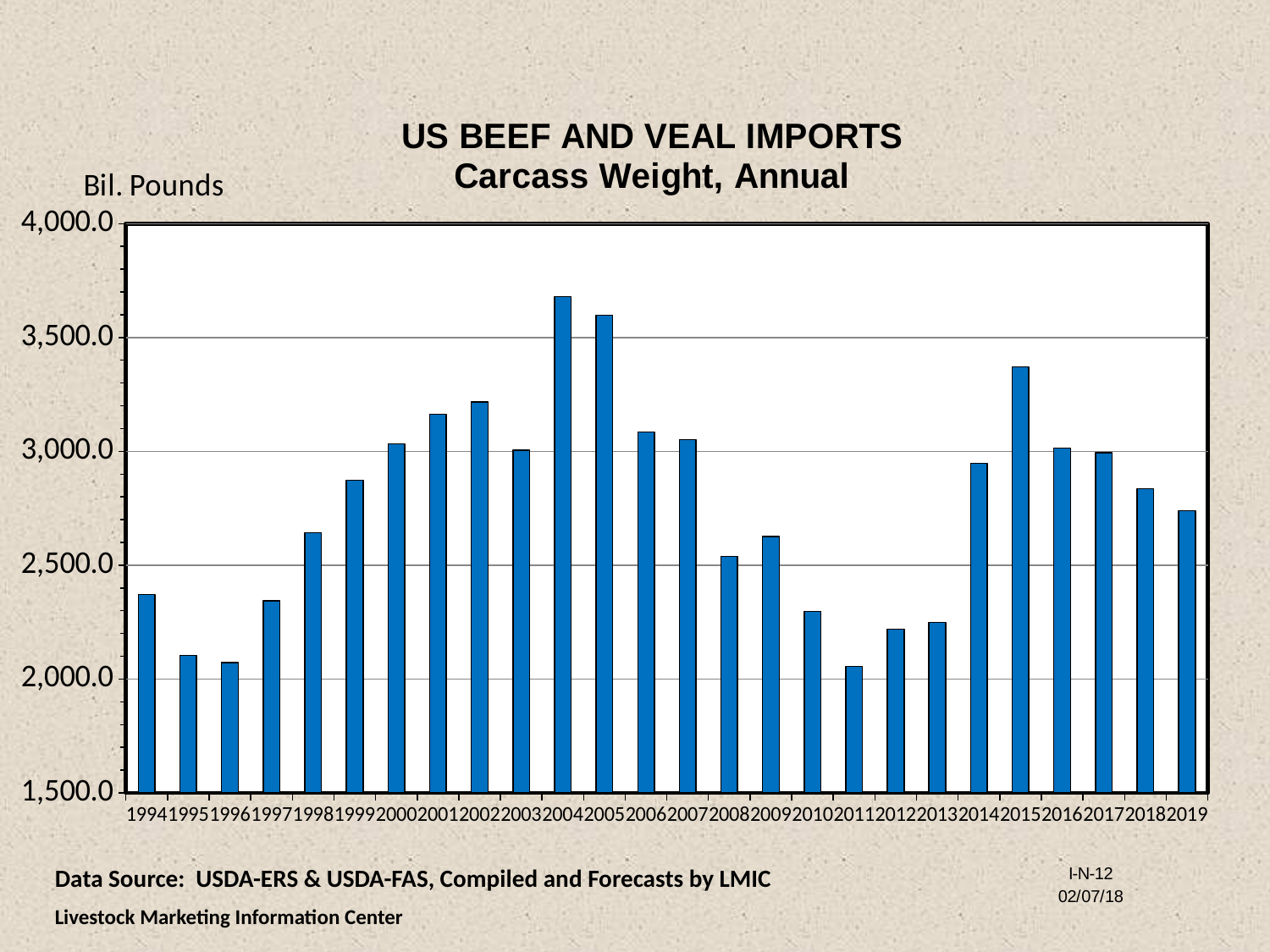
How many years are plotted on the x axis? 26 Do the values rise or fall from 2015 to 2019? fall Is the value for 2010 greater or less than 2,500.0? less Which is larger, the value for 1994 or the value for 1995? 1994 Is the value for 2004 greater or less than 3,500.0? greater Which year has the highest value for US beef and veal imports? 2004 What unit is shown on the y axis label? Bil. Pounds Which is larger, the value for 2015 or the value for 2016? 2015 What kind of chart is shown on the slide? bar chart Is the value for 2011 greater or less than 2,500.0? less